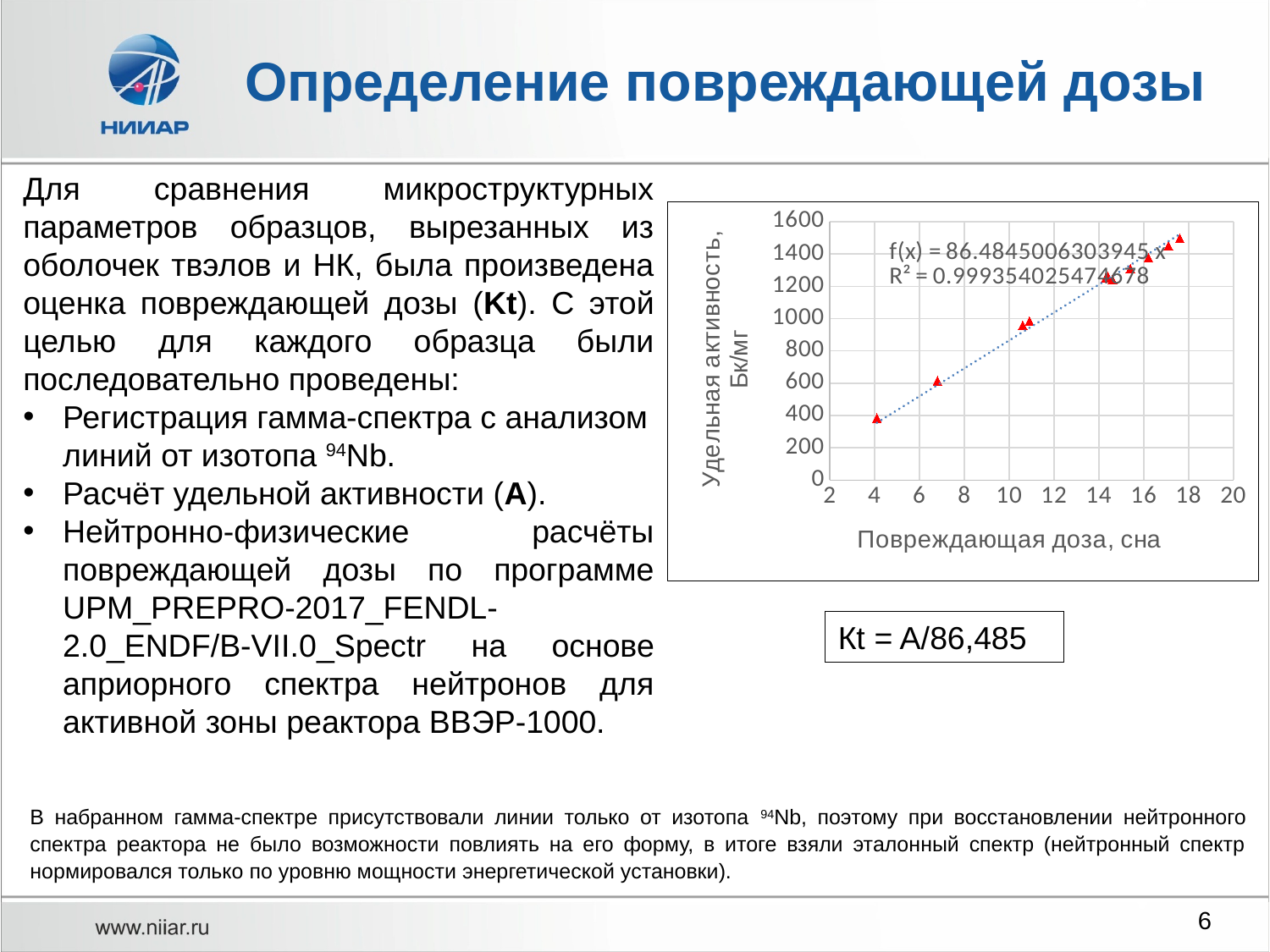
Is the specific activity of the point at a damaging dose of about 14.5 сна greater or less than 1000? greater What kind of chart is shown on the slide? scatter chart Is the specific activity of the lowest plotted point greater or less than 600? less Which has the higher specific activity: the point at a dose of about 4 сна or the point at a dose of about 11 сна? the point at about 11 сна What is the title of the x axis of the chart? Повреждающая доза, сна What is the trendline equation printed on the chart? f(x) = 86.4845006303945x Is the specific activity of the point at a damaging dose of about 7 сна greater or less than 400? greater What is the maximum value shown on the y axis of the chart? 1600 Do the plotted values rise or fall as the damaging dose increases along the x axis? rise What R² value is printed on the chart? 0.999354025474678